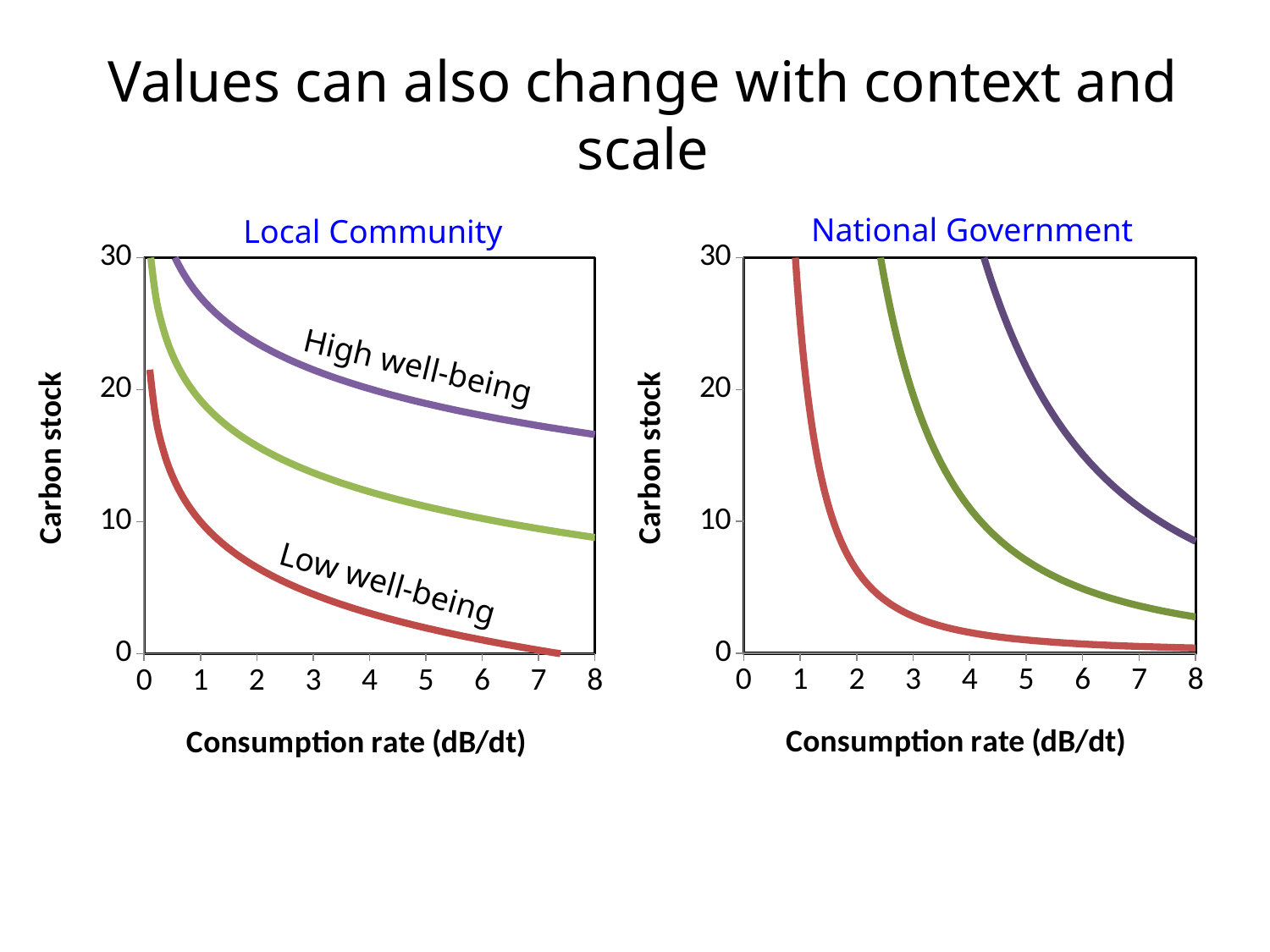
How many curves are plotted on the National Government chart? 3 What kind of chart is the Local Community chart? line chart On the National Government chart, is the value of the red curve at consumption rate 4 greater or less than 10? less On the National Government chart, does the red curve rise or fall as consumption rate increases? fall How many charts are shown on the slide? 2 On the Local Community chart, which labelled curve is the highest? High well-being On the National Government chart, is the value of the purple curve at consumption rate 8 greater or less than 20? less On the Local Community chart, is the value of the Low well-being curve at consumption rate 4 greater or less than 10? less On the Local Community chart, does the High well-being curve rise or fall as consumption rate increases? fall What is the x-axis label on the National Government chart? Consumption rate (dB/dt) On the Local Community chart, at consumption rate 4, which curve is higher, High well-being or Low well-being? High well-being